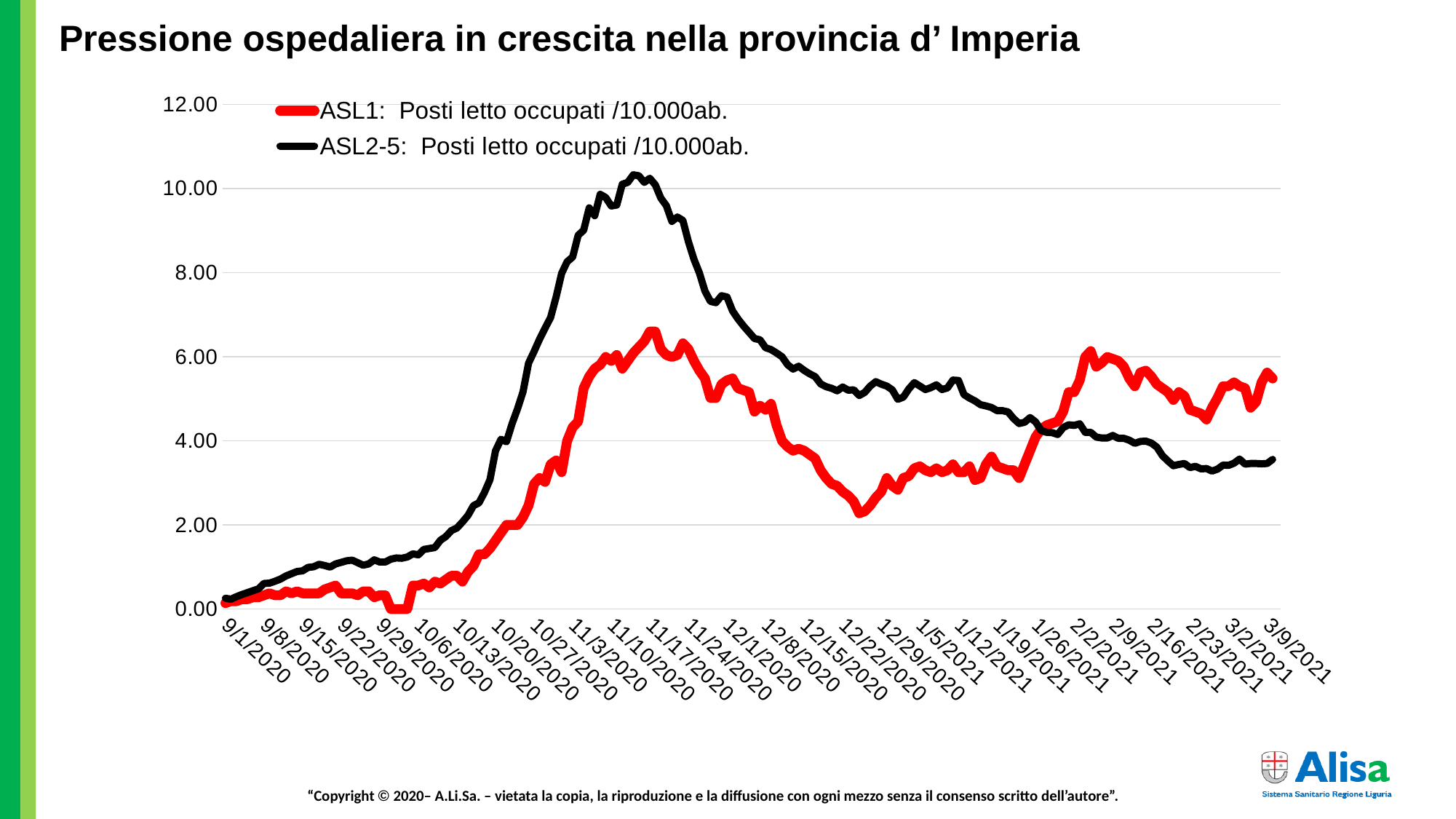
What is the title of the slide's chart? Pressione ospedaliera in crescita nella provincia d' Imperia Does the ASL2-5 series rise or fall between 11/10/2020 and 3/9/2021? fall At 11/10/2020, which series has the higher value, ASL1 or ASL2-5? ASL2-5 Is the value of the ASL1 series at 3/9/2021 greater or less than 4.00? greater Which series reaches the higher peak value over the whole period? ASL2-5 Is the value of the ASL2-5 series at 3/9/2021 greater or less than 4.00? less Is the value of the ASL1 series around 12/22/2020 greater or less than 4.00? less Which colour is used for the ASL1 series? red What kind of chart is shown on the slide? line chart At 3/9/2021, which series has the higher value, ASL1 or ASL2-5? ASL1 How many series does the legend list? 2